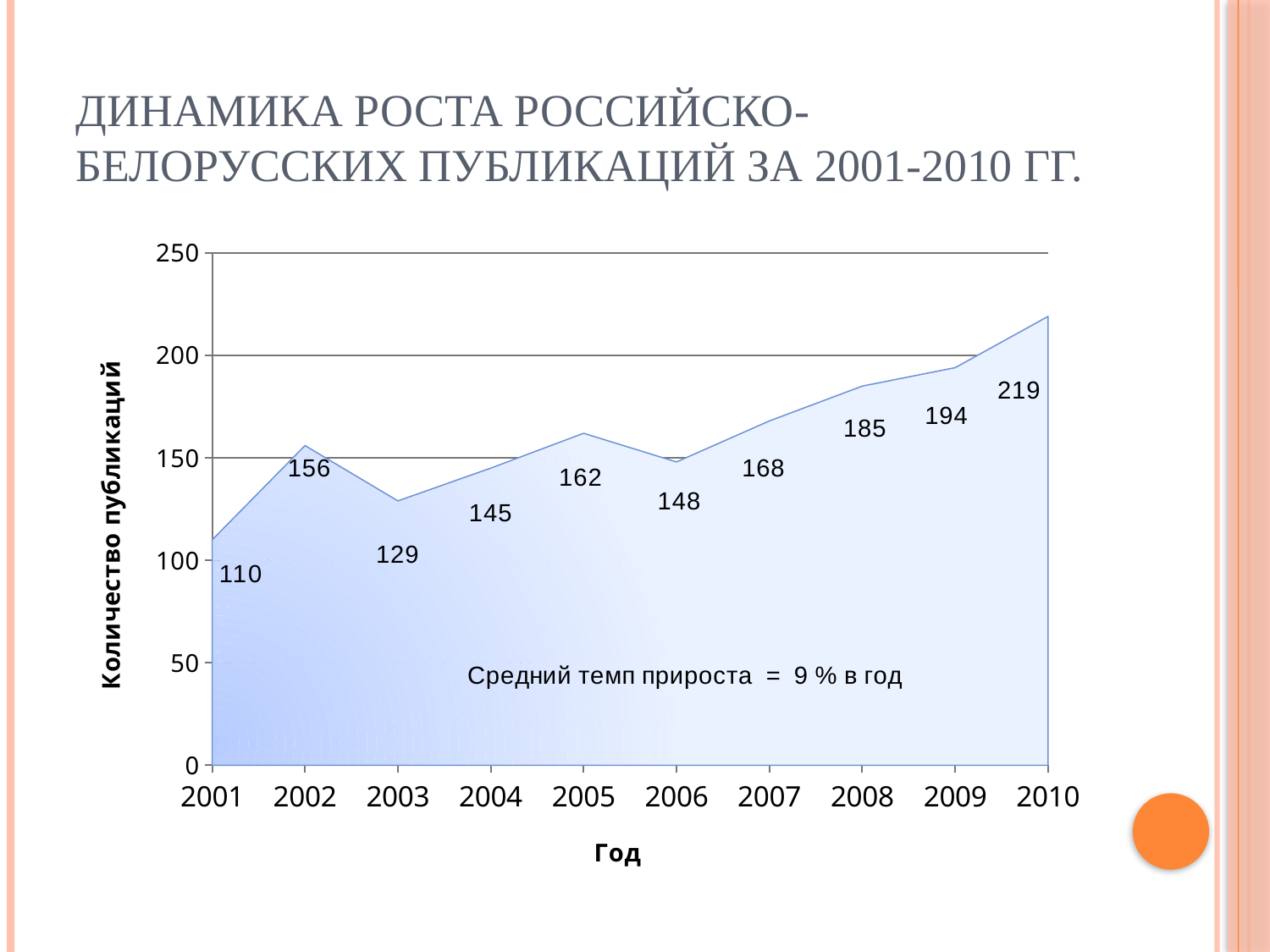
What is the number of publications in 2005? 162 What kind of chart is shown on the slide? area chart Which year has the highest number of publications? 2010 Which year has the lowest number of publications? 2001 Is the value for 2009 greater or less than 200? less How many years are shown on the x axis? 10 Which year has more publications, 2006 or 2007? 2007 What is the difference between the number of publications in 2010 and in 2001? 109 What is the difference between the number of publications in 2002 and in 2003? 27 What is the number of publications in 2001? 110 What is the number of publications in 2008? 185 What is the average annual growth rate stated on the chart? 9 % в год